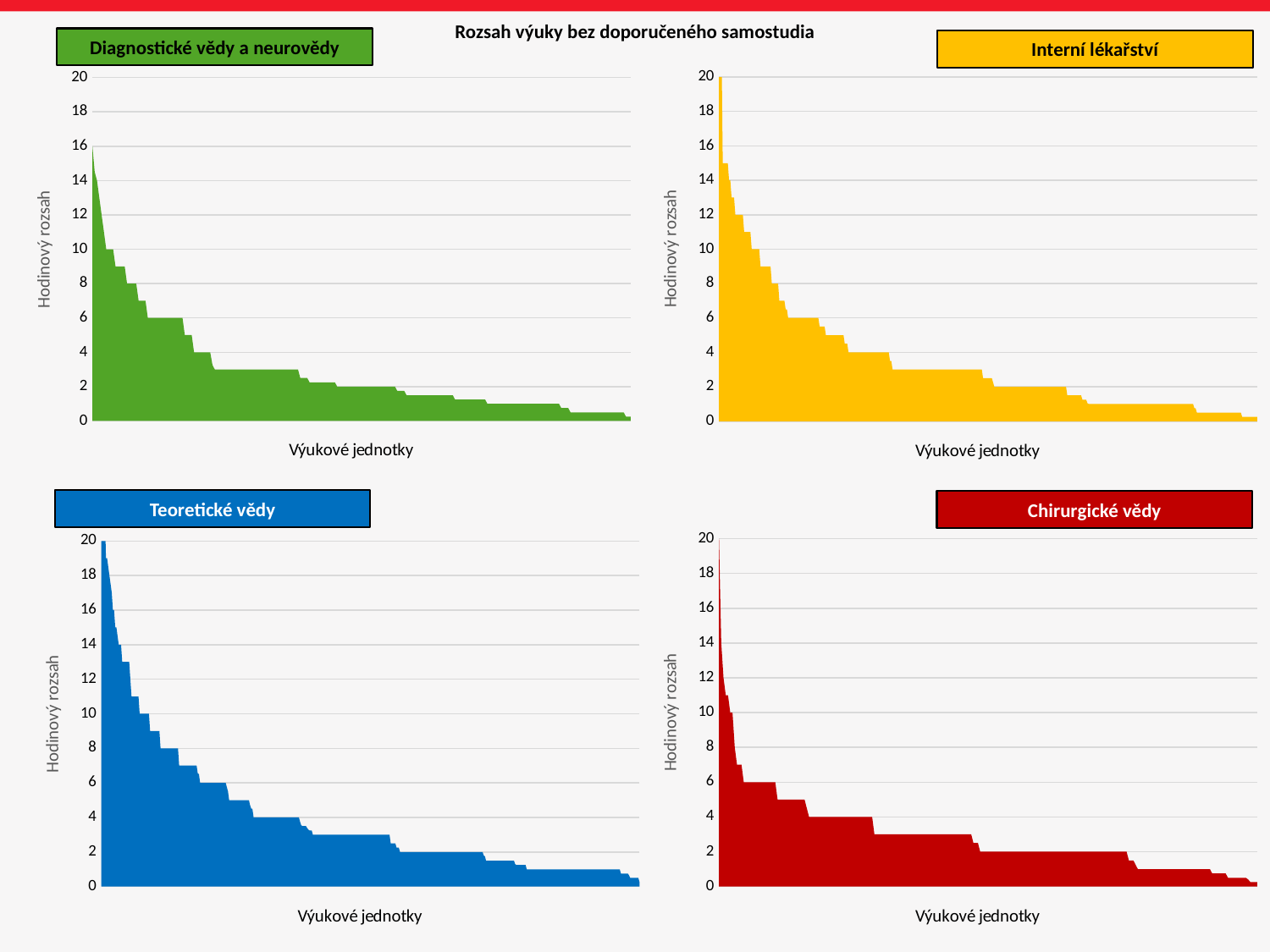
In the "Diagnostické vědy a neurovědy" chart, is the highest value greater or less than 14? greater In the "Teoretické vědy" chart, is the highest value greater or less than 16? greater In the "Diagnostické vědy a neurovědy" chart, do the values rise or fall along the x axis? Fall What kind of chart is the "Diagnostické vědy a neurovědy" chart? Area chart What is the overall title shown above the charts on the slide? Rozsah výuky bez doporučeného samostudia In the "Interní lékařství" chart, do the values rise or fall along the x axis? Fall In the "Interní lékařství" chart, is the highest value greater or less than 18? greater Which of the four charts has the lowest peak value? Diagnostické vědy a neurovědy In the "Teoretické vědy" chart, do the values rise or fall along the x axis? Fall What kind of chart is the "Chirurgické vědy" chart? Area chart What colour is the area in the "Interní lékařství" chart? Yellow